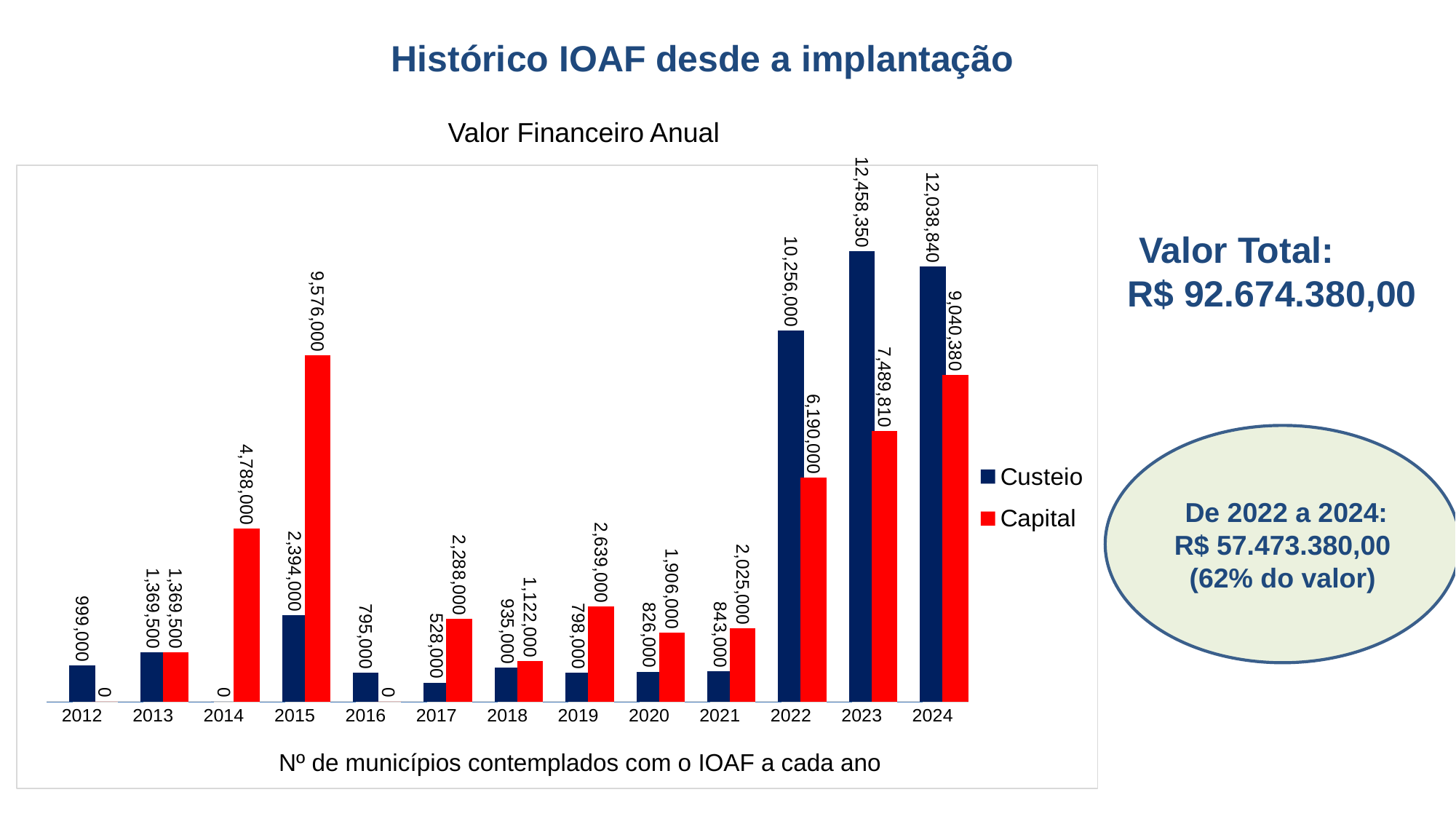
Which year has the highest Capital value? 2015 What is the Custeio value for 2017? 528,000 Which year has the lowest Custeio value? 2014 How many years are shown on the x axis? 13 How many series does the legend list? 2 What is the Capital value for 2024? 9,040,380 What is the difference between the Custeio and Capital values in 2023? 4,968,540 In 2022, which series has the larger value, Custeio or Capital? Custeio What is the Capital value for 2015? 9,576,000 What is the Custeio value for 2023? 12,458,350 Which year has the highest Custeio value? 2023 What type of chart is shown? Bar chart